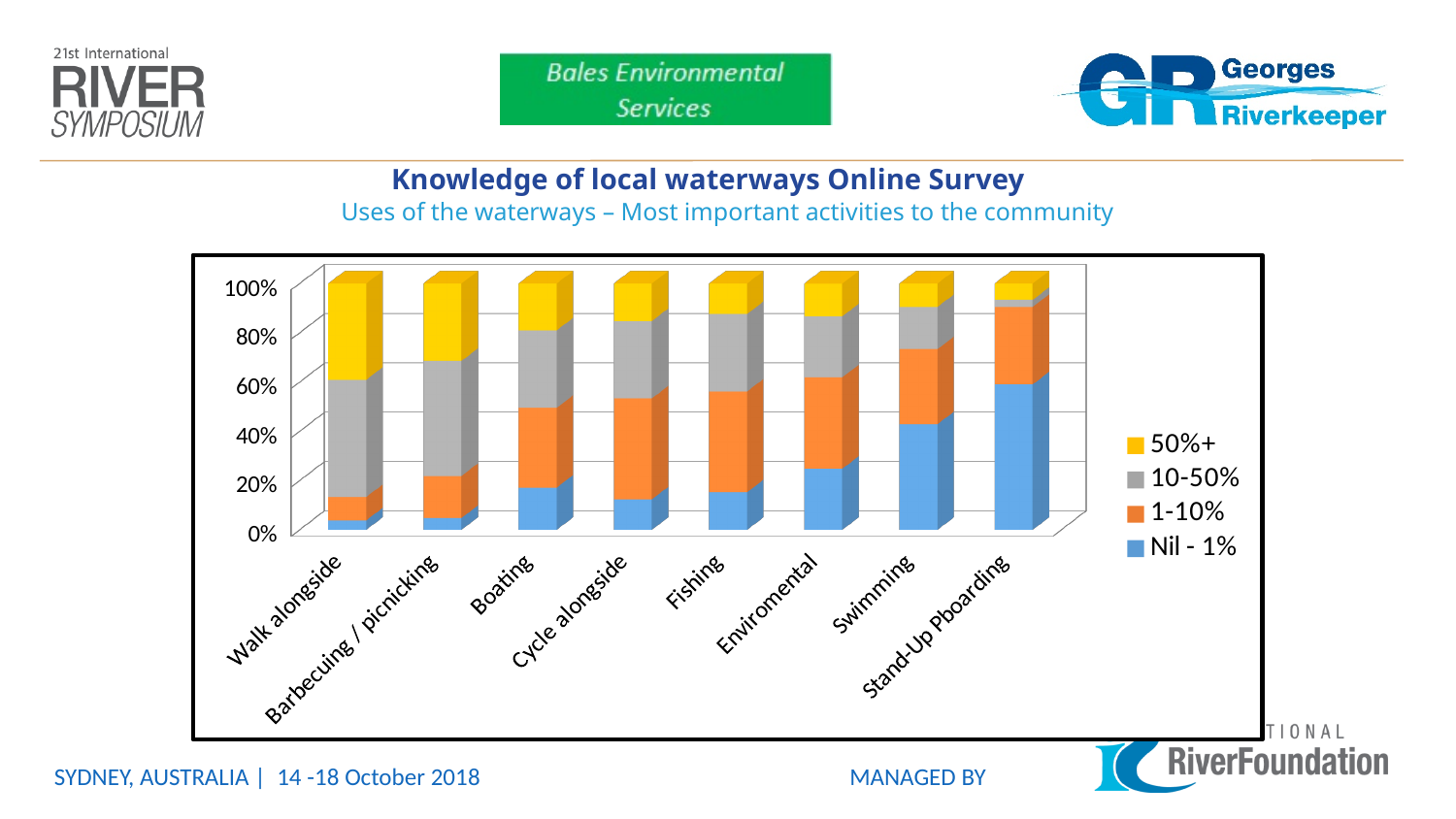
Is the 'Nil - 1%' value for Stand-Up Pboarding greater or less than 40%? greater Which has the larger 'Nil - 1%' segment, Swimming or Fishing? Swimming What colour represents the '50%+' series in the legend? yellow Which activity has the smallest '50%+' segment? Stand-Up Pboarding How many series does the legend list? 4 How many activity categories are shown on the x axis? 8 Which has the larger '50%+' segment, Walk alongside or Boating? Walk alongside Which activity has the largest 'Nil - 1%' segment? Stand-Up Pboarding Moving from left to right along the x axis, does the 'Nil - 1%' segment generally rise or fall? rise Is the 'Nil - 1%' value for Walk alongside greater or less than 20%? less Which activity has the largest '50%+' segment? Walk alongside What kind of chart is shown on the slide? bar chart